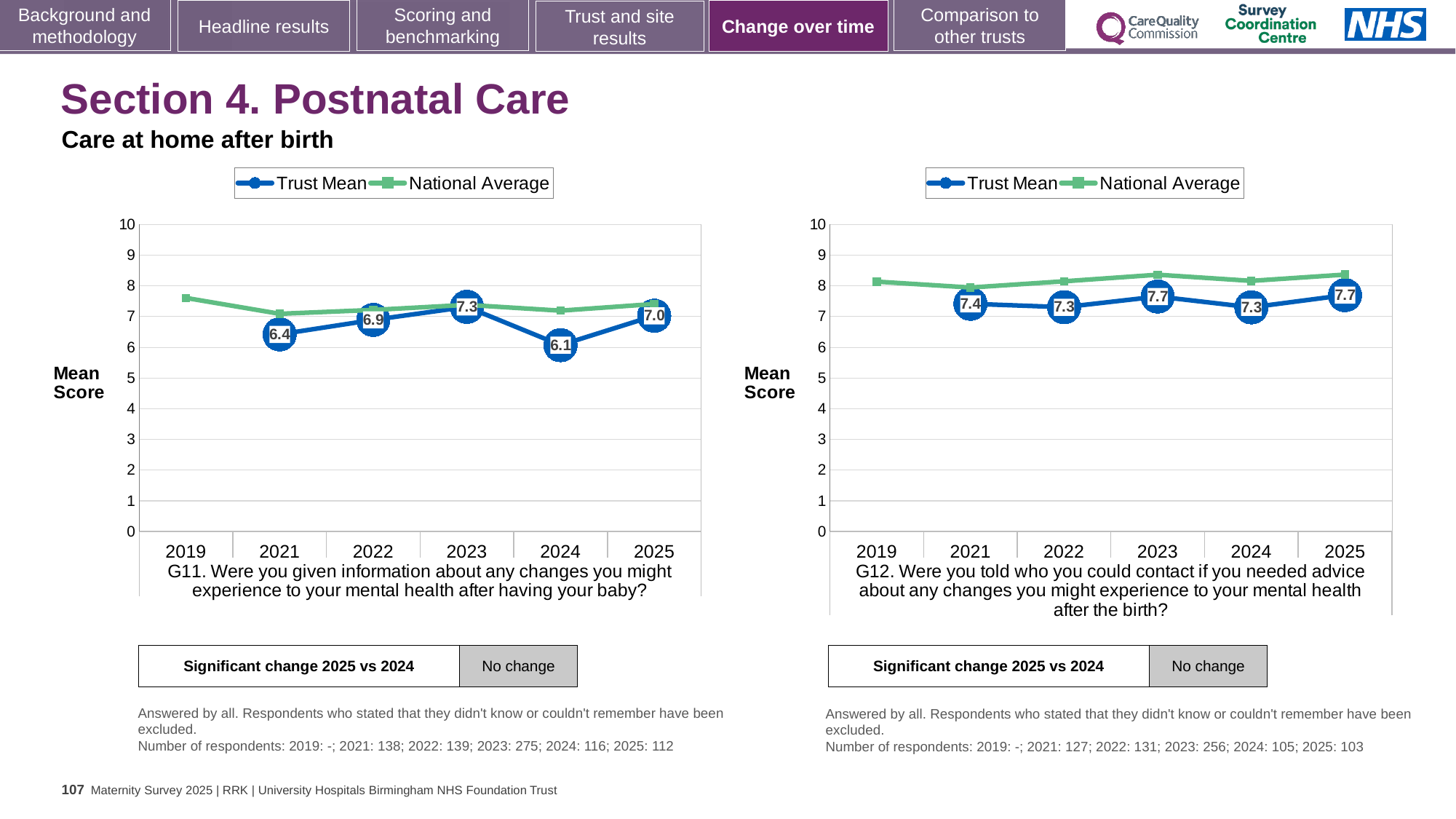
In the G12 chart on the right, what is the Trust Mean score for 2021? 7.4 In the G11 chart on the left, is the National Average value for 2019 greater or less than 7? greater In the G11 chart on the left, what is the Trust Mean score for 2024? 6.1 How many years are shown on the x axis of the G12 chart on the right? 6 What kind of chart is the G11 chart on the left? Line chart In the G11 chart on the left, which year has the larger Trust Mean score, 2021 or 2022? 2022 In the G12 chart on the right, is the National Average value for 2023 greater or less than 8? greater In the G12 chart on the right, what is the difference between the Trust Mean scores for 2023 and 2022? 0.4 In the G11 chart on the left, which year has the lowest Trust Mean score? 2024 In the G11 chart on the left, which year has the highest Trust Mean score? 2023 In the G11 chart on the left, what is the difference between the Trust Mean scores for 2025 and 2024? 0.9 How many series does the legend of the G11 chart on the left list? 2